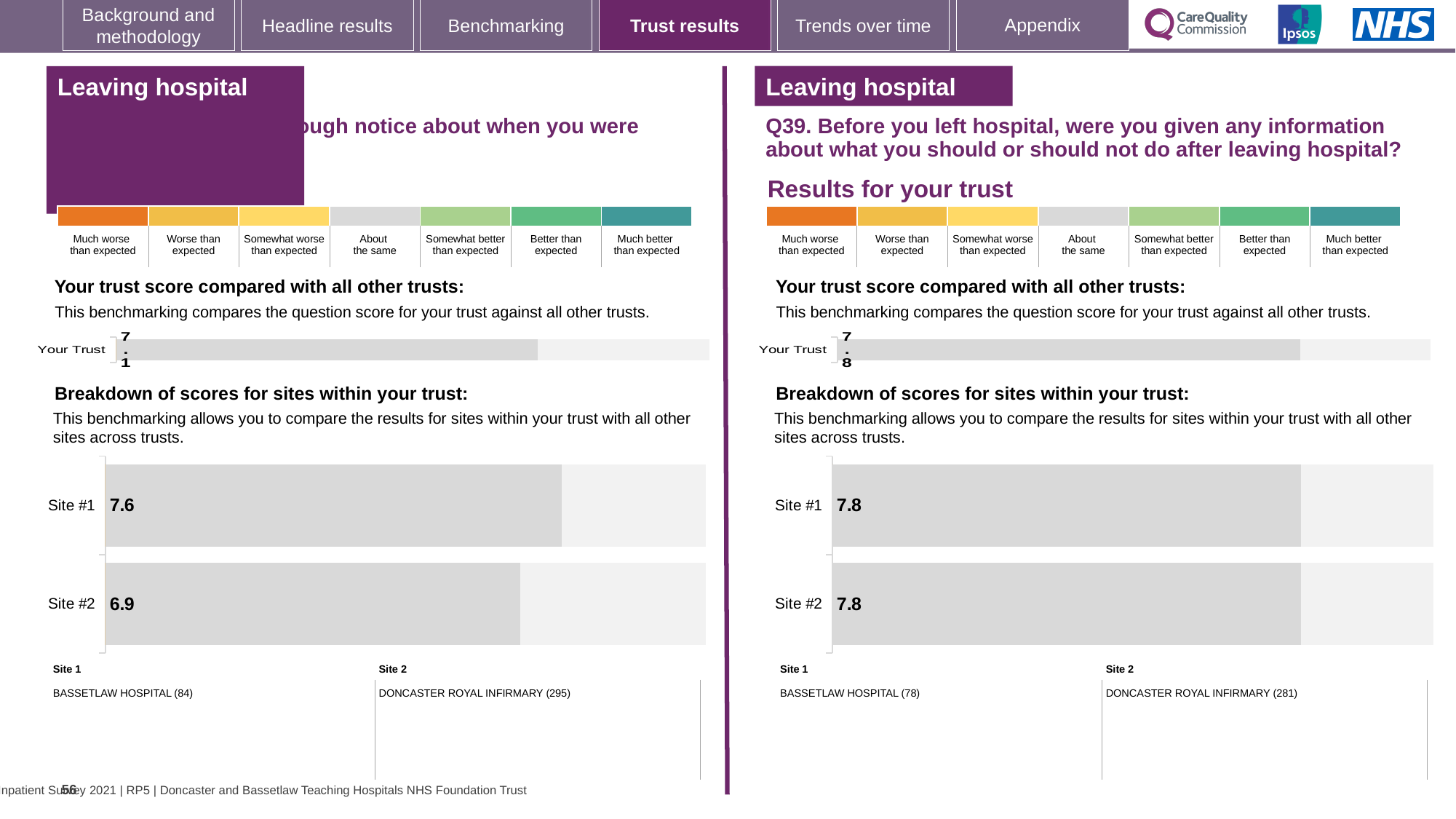
In the left-hand site breakdown chart, what is the difference between the Site #1 and Site #2 scores? 0.7 In the right-hand (Q39) 'Breakdown of scores for sites within your trust' chart, what is the score for Site #1? 7.8 How many sites are shown in the right-hand (Q39) site breakdown chart? 2 In the right-hand (Q39) 'Breakdown of scores for sites within your trust' chart, what is the score for Site #2? 7.8 What type of chart is used for the site breakdown on the right-hand side of the slide? bar chart In the left-hand site breakdown chart, which site has the higher score? Site #1 In the left-hand 'Breakdown of scores for sites within your trust' chart, what is the score for Site #2? 6.9 In the left-hand 'Breakdown of scores for sites within your trust' chart, what is the score for Site #1? 7.6 On the right-hand side of the slide (Q39), what is the score shown for Your Trust in the 'Your trust score compared with all other trusts' chart? 7.8 Which site is listed as Site 2 beneath the right-hand (Q39) site breakdown chart? DONCASTER ROYAL INFIRMARY (281) In the left-hand site breakdown chart, is the score for Site #1 larger or smaller than the score for Site #2? larger On the left-hand side of the slide, what is the score shown for Your Trust in the 'Your trust score compared with all other trusts' chart? 7.1